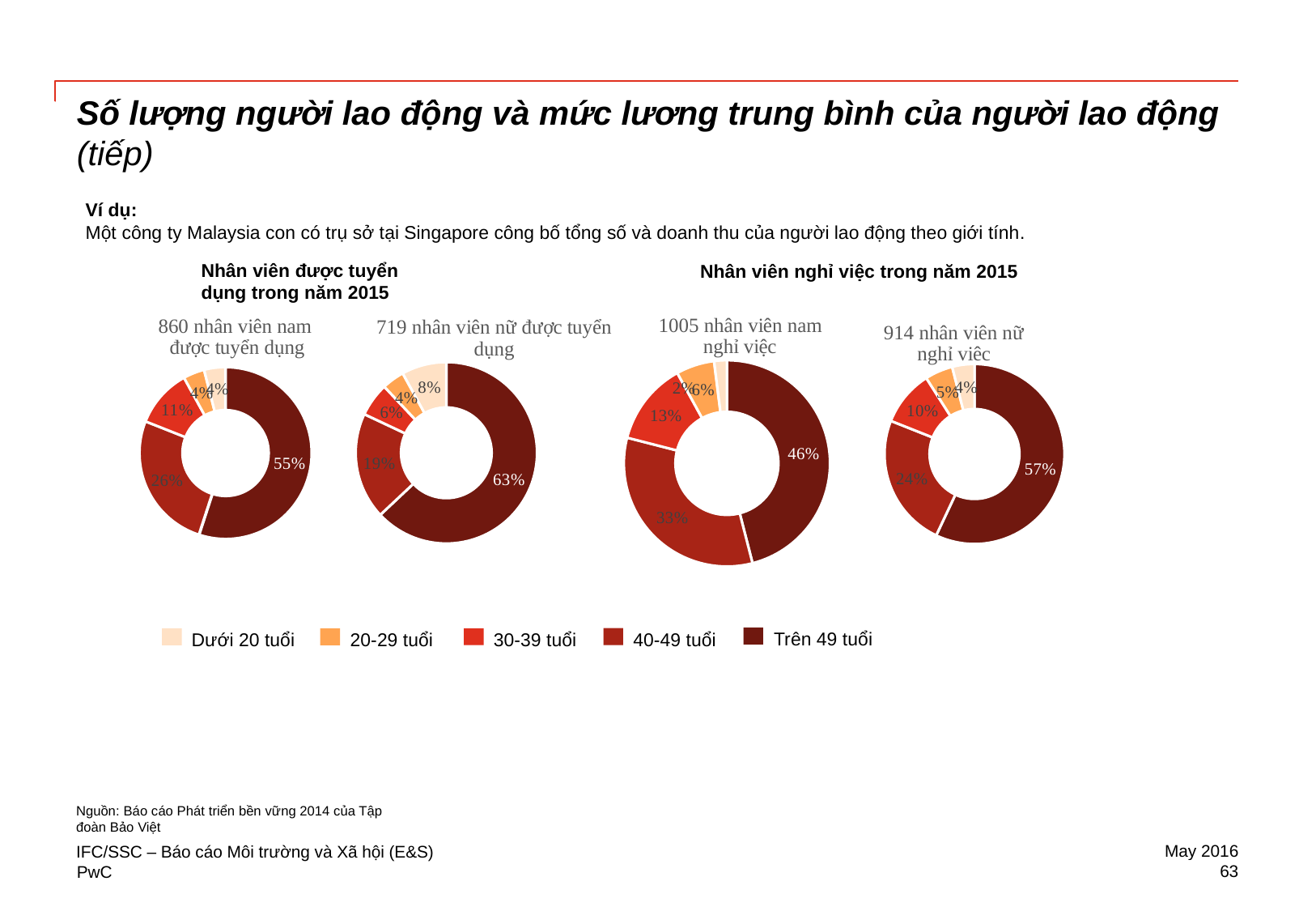
In the chart for 719 nhân viên nữ được tuyển dụng, which age group has the smallest share? 20-29 tuổi How many age groups does the legend list? 5 How many donut charts are shown on the slide? 4 What type of chart is used for 860 nhân viên nam được tuyển dụng? Donut (pie) chart In the chart for 1005 nhân viên nam nghỉ việc, what share is 40-49 tuổi? 33% In the chart for 719 nhân viên nữ được tuyển dụng, what share is 40-49 tuổi? 19% In the chart for 914 nhân viên nữ nghỉ việc, which age group has the largest share? Trên 49 tuổi What is the title above the two right-hand charts? Nhân viên nghỉ việc trong năm 2015 Which is larger: the Trên 49 tuổi share for 1005 nhân viên nam nghỉ việc or for 914 nhân viên nữ nghỉ việc? 914 nhân viên nữ nghỉ việc In the chart for 860 nhân viên nam được tuyển dụng, what is the difference between the Trên 49 tuổi share and the 40-49 tuổi share? 29% In the chart for 860 nhân viên nam được tuyển dụng, what share is Trên 49 tuổi? 55% In the chart for 914 nhân viên nữ nghỉ việc, what share is 30-39 tuổi? 10%